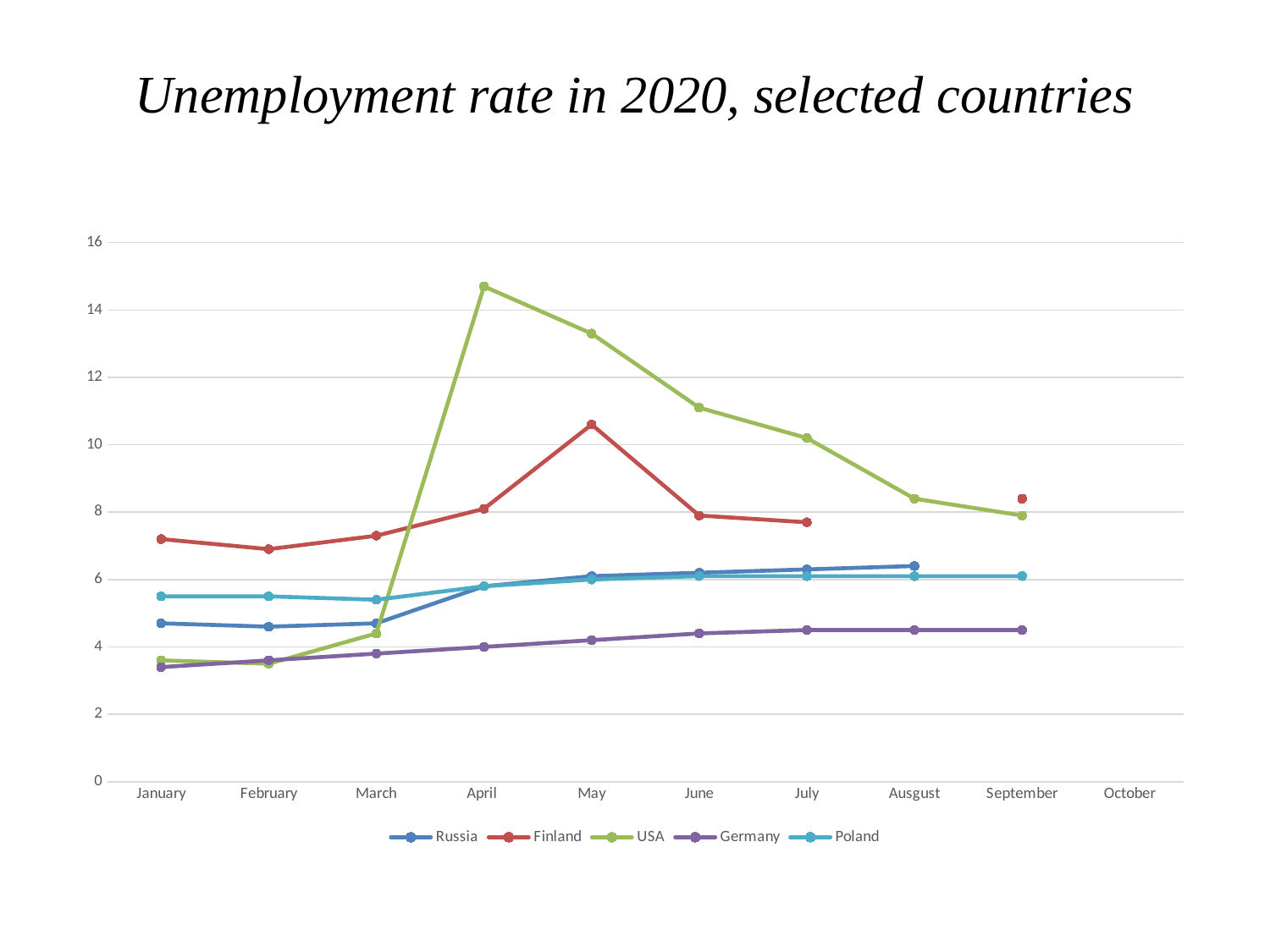
In which month does the USA line reach its highest value? April How many series does the legend list? 5 Which country has the lowest unemployment rate in September? Germany Is the value for USA in April greater or less than 14? greater What is the title of the chart? Unemployment rate in 2020, selected countries Which country has the highest unemployment rate in April? USA What kind of chart is shown on the slide? line chart In which month does the Finland line reach its highest value? May Does the USA line rise or fall from April to September? fall Is the value for Germany in January greater or less than 4? less How many month labels are shown on the x axis? 10 Which is larger in January, the value for Finland or the value for Russia? Finland